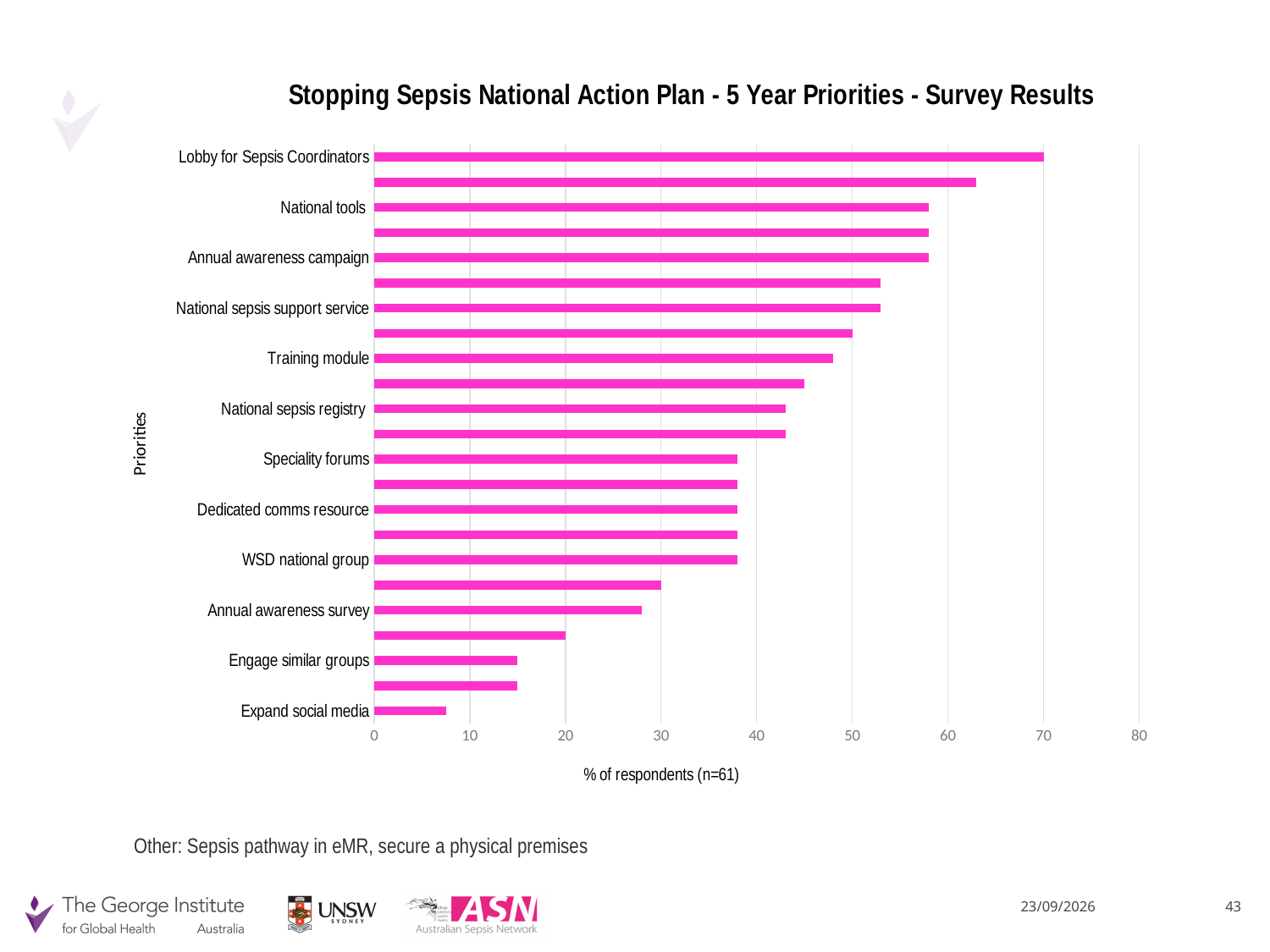
Is the value for National tools greater or less than 50? greater What kind of chart is shown on the slide? Bar chart Which priority has the highest percentage of respondents? Lobby for Sepsis Coordinators Is the value for Expand social media greater or less than 10? less What is the label on the horizontal axis of the chart? % of respondents (n=61) Is the value for Training module greater or less than 50? less Which has a higher percentage of respondents, Annual awareness survey or Engage similar groups? Annual awareness survey Which has a higher percentage of respondents, Training module or National sepsis registry? Training module Which priority has the lowest percentage of respondents? Expand social media